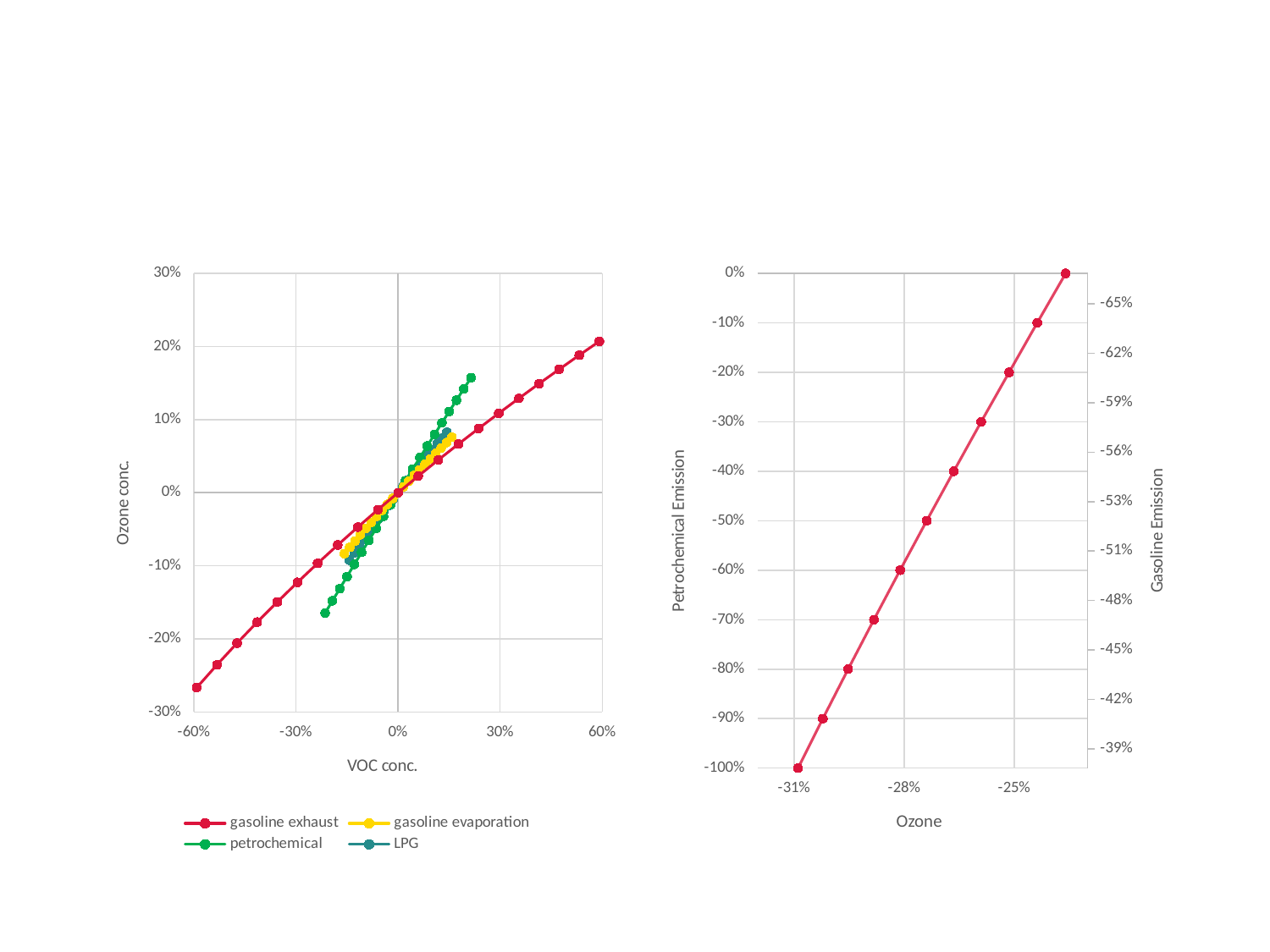
On the left chart, what kind of chart is shown? line chart On the left chart, which series extends to the highest VOC conc. value on the x axis? gasoline exhaust On the left chart, which series reaches a higher ozone conc.: gasoline exhaust or gasoline evaporation? gasoline exhaust On the left chart, does the ozone conc. for gasoline exhaust rise or fall as VOC conc. increases? rise On the left chart, what is the title of the x axis? VOC conc. On the right chart, what is the title of the left y axis? Petrochemical Emission On the right chart, does Petrochemical Emission rise or fall as Ozone increases along the x axis? rise On the right chart, is the Ozone value at the point where Petrochemical Emission is 0% greater or less than -25%? greater On the left chart, is the ozone conc. for gasoline exhaust at -60% VOC conc. greater or less than -20%? less On the right chart, how many data points are plotted? 11 On the left chart, how many series does the legend list? 4 On the left chart, is the highest ozone conc. reached by the petrochemical series greater or less than 10%? greater